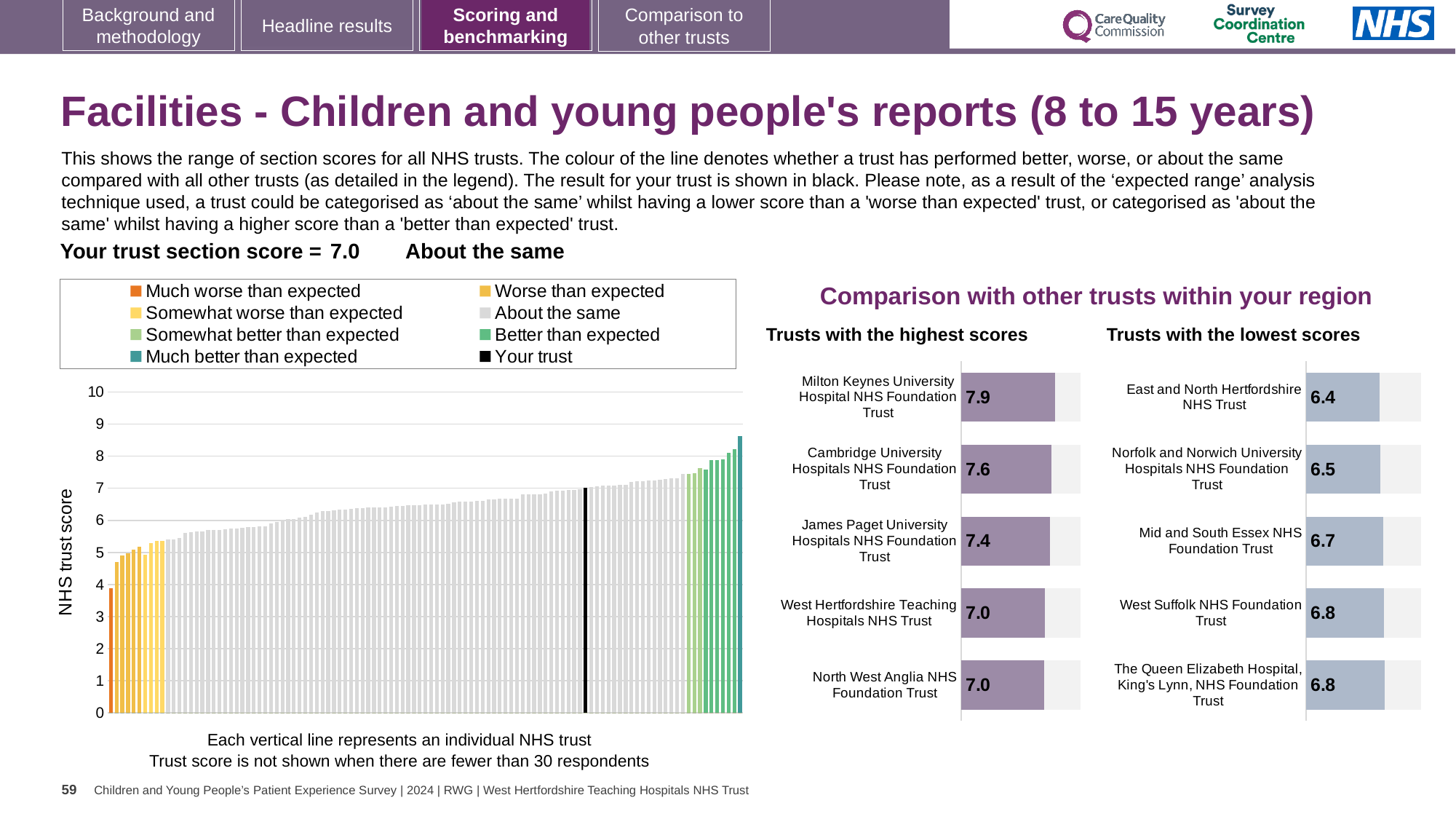
In the 'Trusts with the lowest scores' chart, what is the difference between the scores of West Suffolk NHS Foundation Trust and East and North Hertfordshire NHS Trust? 0.4 In the 'Trusts with the highest scores' chart, what is the score for Milton Keynes University Hospital NHS Foundation Trust? 7.9 In the 'Trusts with the highest scores' chart, what is the score for James Paget University Hospitals NHS Foundation Trust? 7.4 In the 'Trusts with the lowest scores' chart, which trust has the lowest score? East and North Hertfordshire NHS Trust How many entries does the legend of the large 'NHS trust score' chart on the left list? 8 In the 'Trusts with the lowest scores' chart, what is the score for Norfolk and Norwich University Hospitals NHS Foundation Trust? 6.5 In the 'Trusts with the lowest scores' chart, which has the larger score: Mid and South Essex NHS Foundation Trust or Norfolk and Norwich University Hospitals NHS Foundation Trust? Mid and South Essex NHS Foundation Trust How many trusts are shown in the 'Trusts with the highest scores' chart? 5 In the 'Trusts with the highest scores' chart, which trust has the highest score? Milton Keynes University Hospital NHS Foundation Trust In the large 'NHS trust score' chart on the left, is the value of the tallest bar greater or less than 8? greater What kind of chart is the large chart on the left with the y-axis labelled 'NHS trust score'? Bar chart In the 'Trusts with the highest scores' chart, what is the difference between the scores of Milton Keynes University Hospital NHS Foundation Trust and West Hertfordshire Teaching Hospitals NHS Trust? 0.9